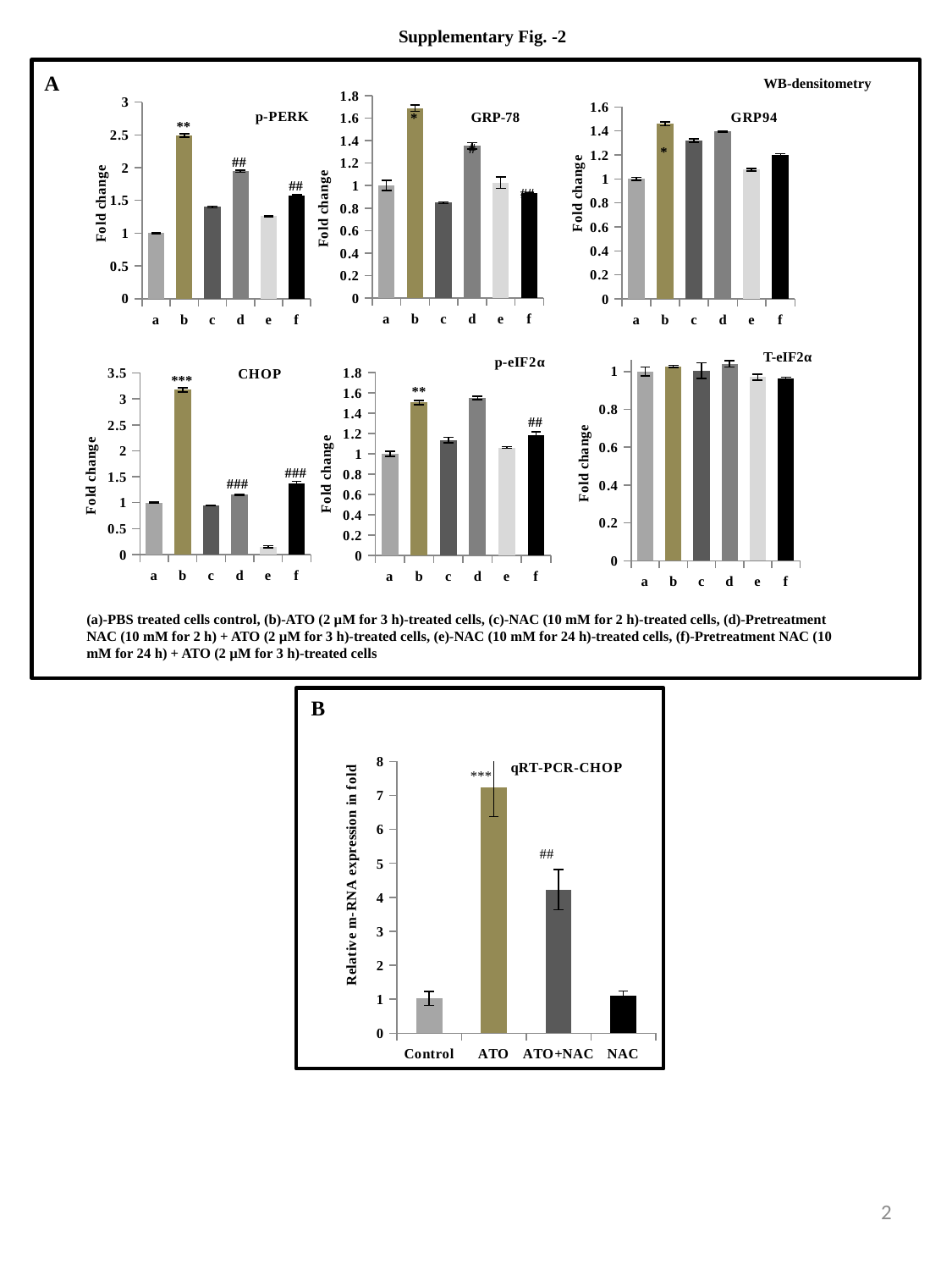
What is the y-axis title of the qRT-PCR-CHOP chart? Relative m-RNA expression in fold In the qRT-PCR-CHOP chart, which is larger, the value for ATO or the value for ATO+NAC? ATO In the p-eIF2α chart, is the value for b greater or less than 1.4? greater In the CHOP chart, is the value for b greater or less than 3? greater In the CHOP chart, which category has the lowest bar? e How many categories are shown in the T-eIF2α chart? 6 In the p-PERK chart, is the value for b greater or less than 2? greater In the GRP94 chart, which category has the highest bar? b In the qRT-PCR-CHOP chart, which category has the highest bar? ATO In the GRP-78 chart, which category has the lowest bar? c In the p-PERK chart, which category has the highest bar? b